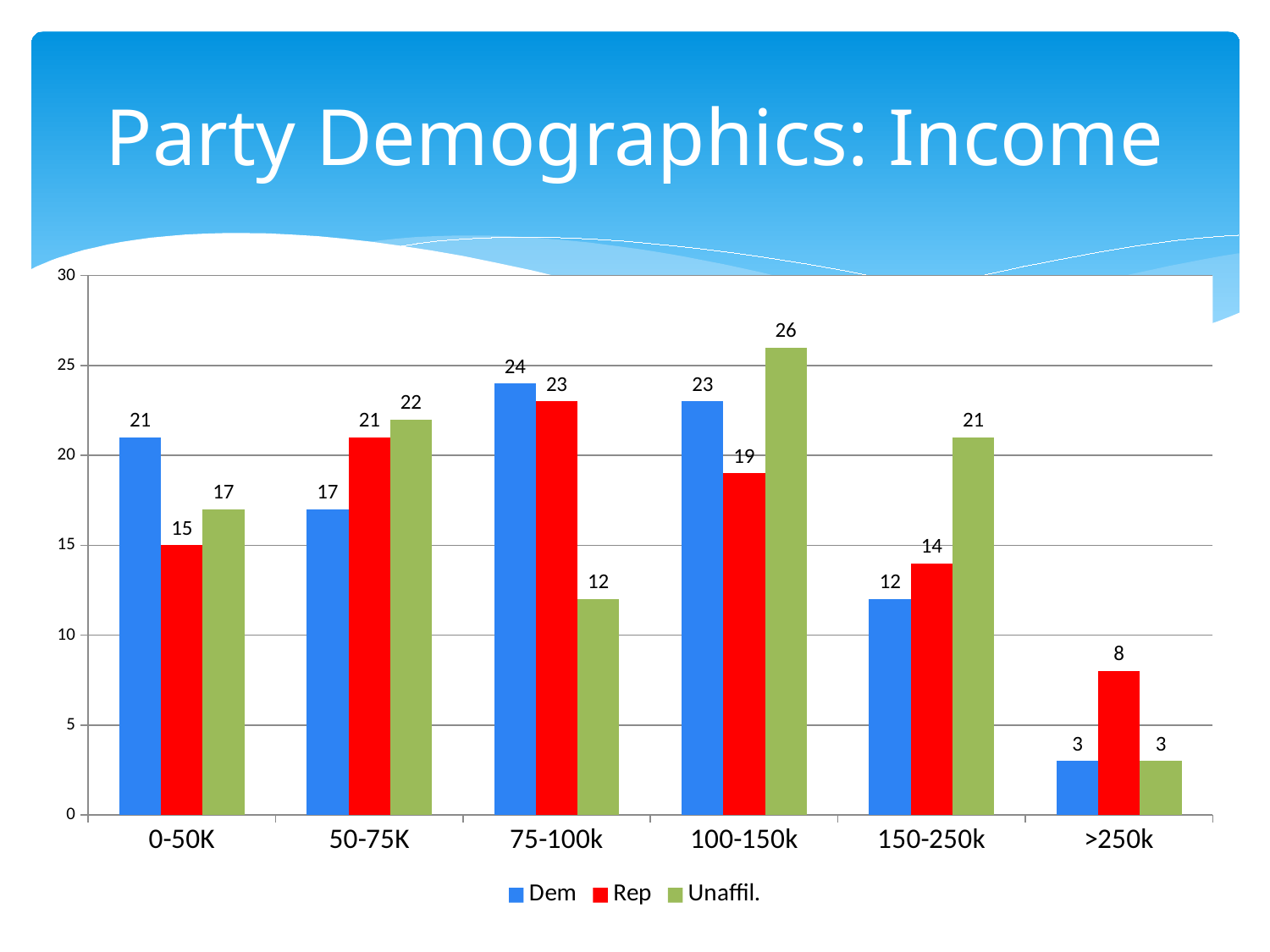
What is the value for Unaffil. in the 100-150k income category? 26 What is the value for Dem in the 0-50K income category? 21 Do the Dem values rise or fall from 100-150k to >250k? fall What is the difference between the Unaffil. and Rep values in the 100-150k category? 7 What kind of chart is shown on the slide? bar chart Which income category has the lowest Unaffil. value? >250k How many income categories are shown on the x axis? 6 Which is larger in the 150-250k category, the Dem value or the Rep value? Rep What is the title of the slide? Party Demographics: Income What is the value for Rep in the >250k income category? 8 Which income category has the highest Dem value? 75-100k How many series does the legend list? 3